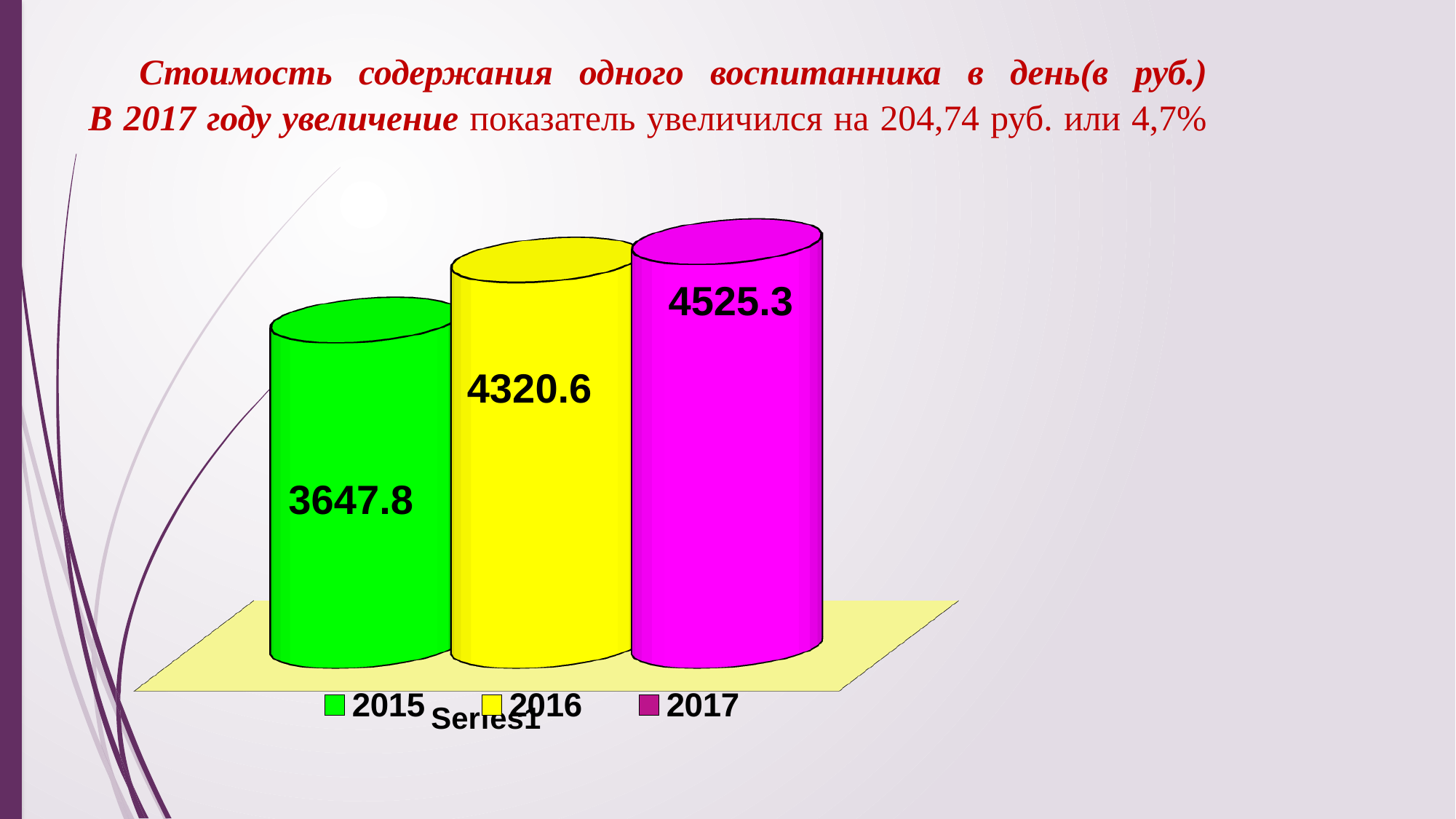
What is the value shown for 2015? 3647.8 What is the value shown for 2016? 4320.6 How many entries does the legend list? 3 Which year has the highest value? 2017 What is the difference between the values for 2017 and 2016? 204.7 How many bars are plotted on the chart? 3 Which year has the lowest value? 2015 Which is larger, the value for 2015 or the value for 2016? 2016 What is the difference between the values for 2016 and 2015? 672.8 What kind of chart is shown on the slide? Bar chart What is the difference between the values for 2017 and 2015? 877.5 What is the value shown for 2017? 4525.3